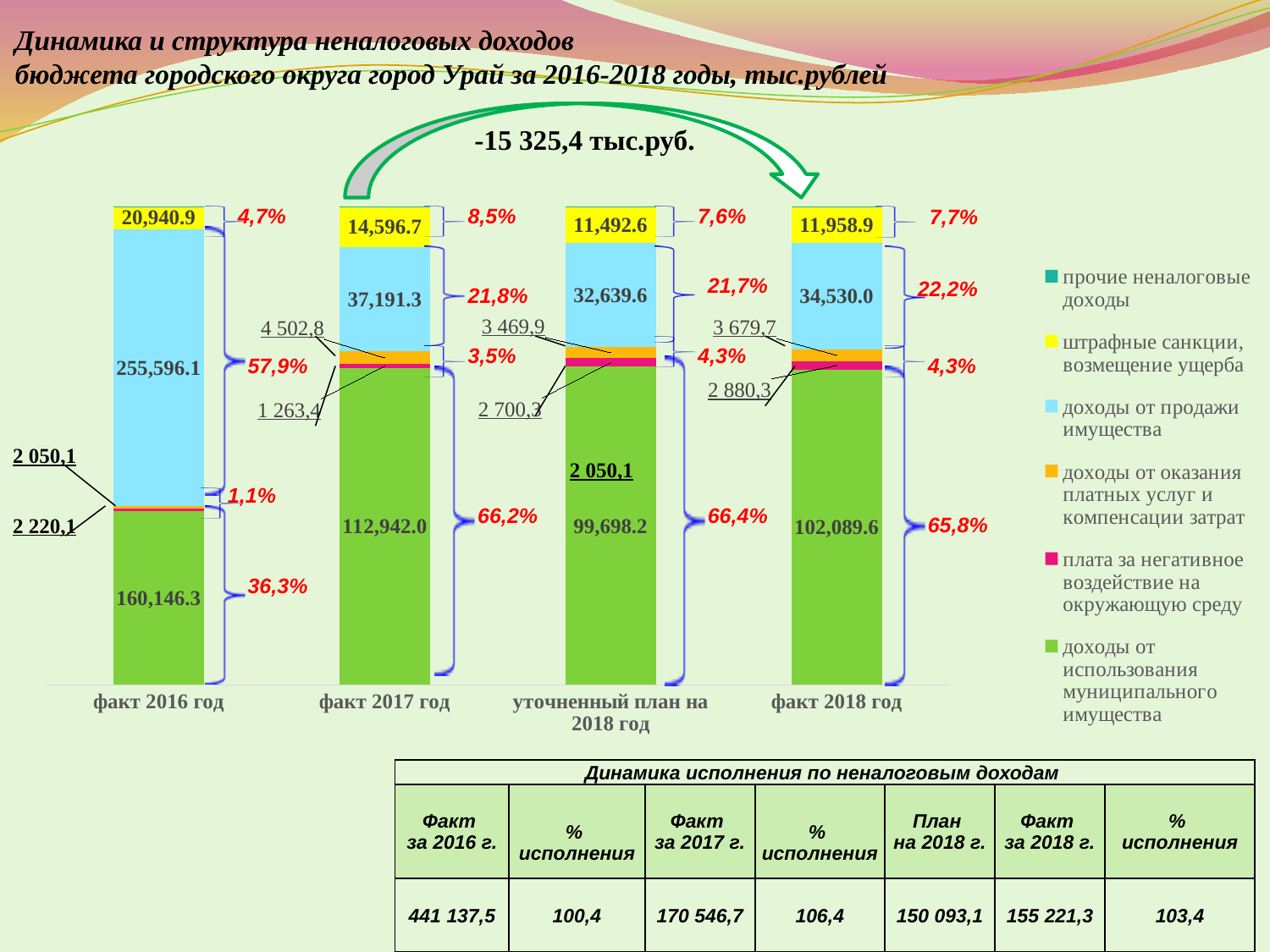
What is the value of штрафные санкции, возмещение ущерба for уточненный план на 2018 год? 11,492.6 What is the value of доходы от продажи имущества for факт 2016 год? 255,596.1 What change in thousand rubles is shown by the green arrow above the chart? -15 325,4 тыс.руб. What is the value of доходы от использования муниципального имущества for факт 2018 год? 102,089.6 What type of chart is shown on the slide? stacked bar chart Which is larger: доходы от использования муниципального имущества for факт 2017 год or for факт 2018 год? факт 2017 год Which category has the highest value for доходы от продажи имущества? факт 2016 год How many series does the chart legend list? 6 How many categories (bars) are shown on the x axis of the chart? 4 What is the difference between доходы от использования муниципального имущества for факт 2016 год and факт 2017 год? 47,204.3 Which category has the lowest value for штрафные санкции, возмещение ущерба? уточненный план на 2018 год What share of the факт 2017 год bar is доходы от использования муниципального имущества, according to the percentage label? 66,2%